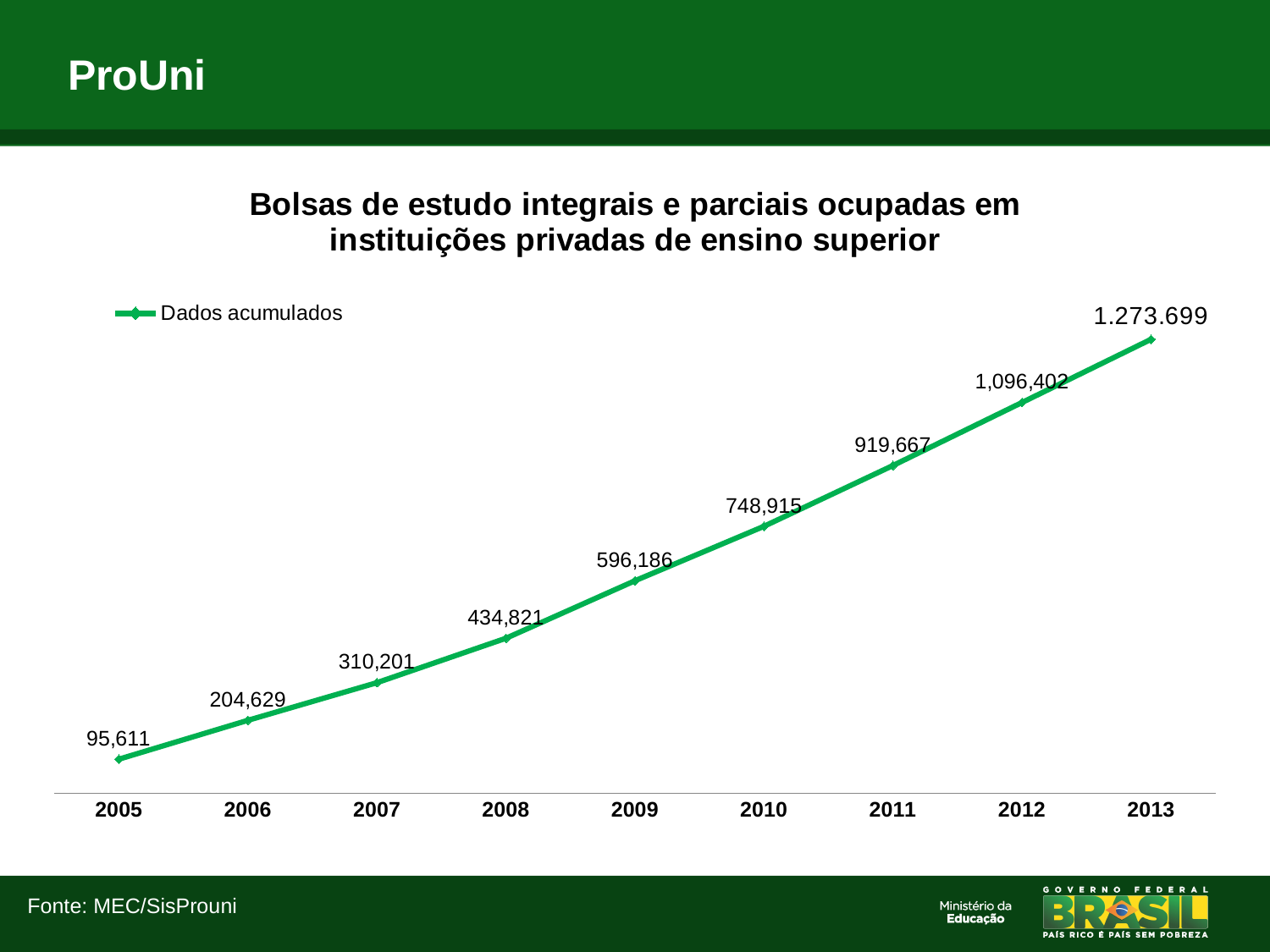
What is the difference between the values for 2013 and 2012? 177,297 Which year has the highest value? 2013 What is the value for 2013? 1.273.699 Which is larger, the value for 2008 or the value for 2010? 2010 How many years are plotted on the x axis? 9 What is the value for 2005? 95,611 Do the values rise or fall from 2005 to 2013? rise Which year has the lowest value? 2005 What is the value for 2009? 596,186 What kind of chart is shown? line chart What is the difference between the values for 2006 and 2005? 109,018 What is the value for 2011? 919,667